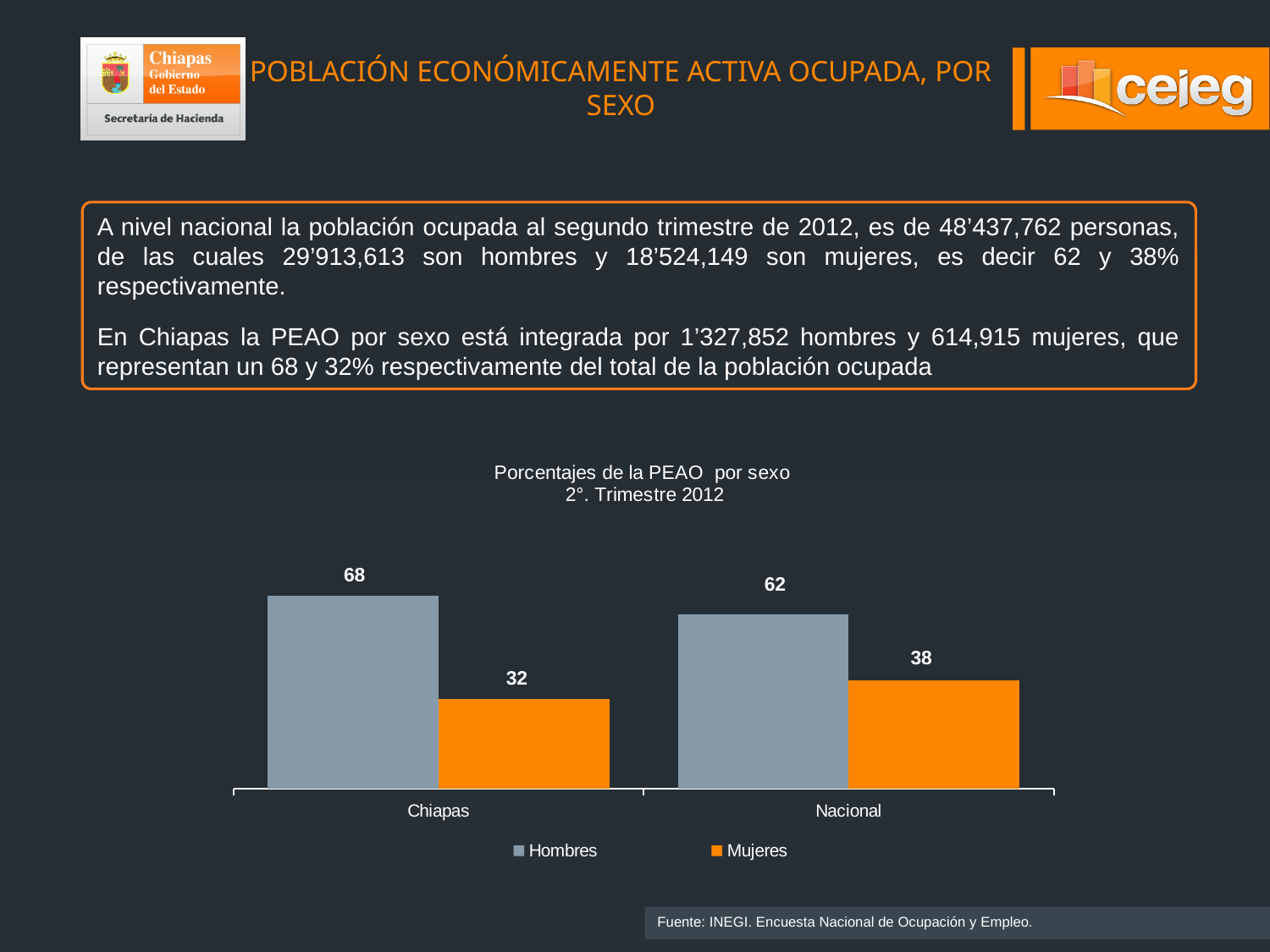
What kind of chart is shown? Bar chart Which category has the lowest Mujeres value? Chiapas Which category has the highest Hombres value? Chiapas What is the difference between the Hombres and Mujeres values in Chiapas? 36 What is the value for Mujeres in Nacional? 38 How many categories are shown on the x axis? 2 What is the value for Hombres in Nacional? 62 How many series does the legend list? 2 Which is larger, the Mujeres value for Chiapas or for Nacional? Nacional What is the value for Hombres in Chiapas? 68 What is the difference between the Hombres values for Chiapas and Nacional? 6 What is the value for Mujeres in Chiapas? 32